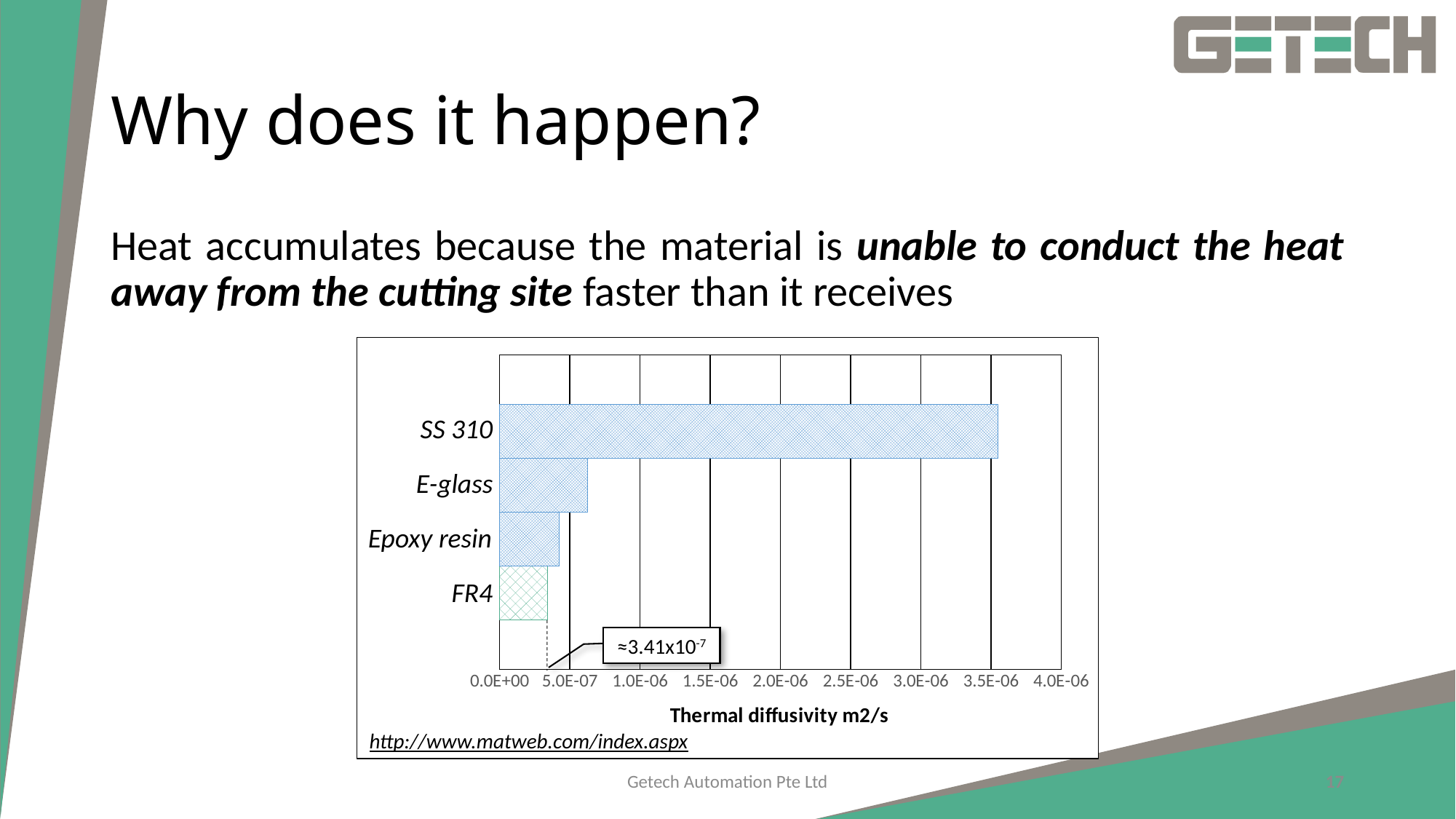
How many materials are plotted in the chart? 4 Which material has the lowest thermal diffusivity in the chart? FR4 Is the thermal diffusivity value for SS 310 greater or less than 4.0E-06? less What is the title of the horizontal axis of the chart? Thermal diffusivity m2/s Which has the larger thermal diffusivity, SS 310 or E-glass? SS 310 What kind of chart is shown on the slide? bar chart Is the thermal diffusivity value for Epoxy resin greater or less than 5.0E-07? less Which has the larger thermal diffusivity, E-glass or Epoxy resin? E-glass Is the thermal diffusivity value for E-glass greater or less than 5.0E-07? greater Which material has the highest thermal diffusivity in the chart? SS 310